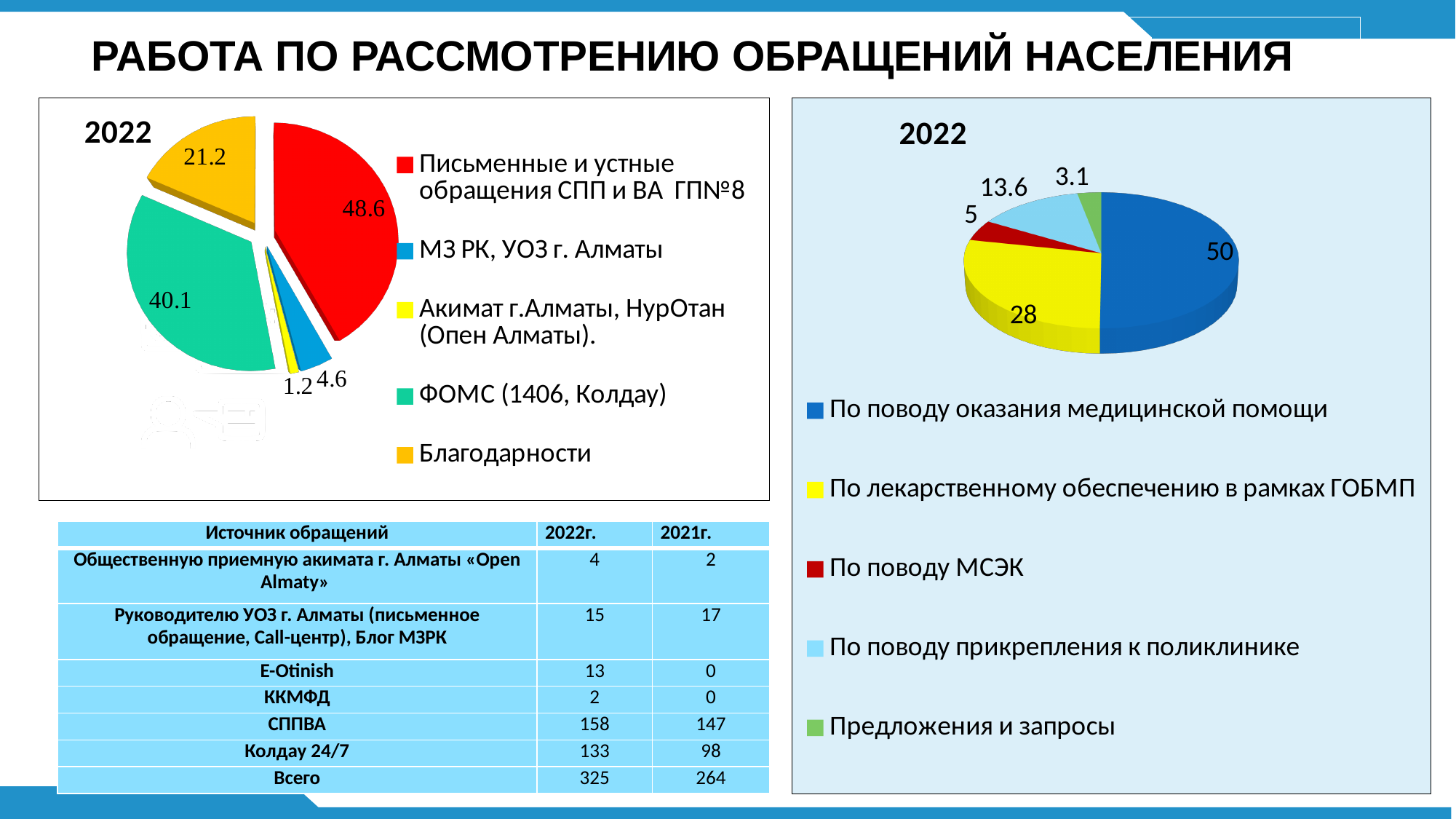
In the left pie chart, which legend category has the smallest slice? Акимат г.Алматы, НурОтан (Опен Алматы). In the right pie chart, which is larger: the value for "По поводу МСЭК" or the value for "По поводу прикрепления к поликлинике"? По поводу прикрепления к поликлинике In the right pie chart, what value is shown for "По поводу прикрепления к поликлинике"? 13.6 What type of chart is shown on the right side of the slide? Pie chart In the left pie chart, what value is shown for the slice labelled "ФОМС (1406, Колдау)"? 40.1 In the left pie chart, what value is shown for "Благодарности"? 21.2 In the left pie chart, which legend category has the largest slice? Письменные и устные обращения СПП и ВА ГП№8 In the right pie chart, which category has the smallest slice? Предложения и запросы In the left pie chart, what is the difference between the values for "Письменные и устные обращения СПП и ВА ГП№8" and "ФОМС (1406, Колдау)"? 8.5 In the right pie chart, which category has the largest slice? По поводу оказания медицинской помощи How many categories does the legend of the left pie chart list? 5 In the right pie chart, what value is shown for "По лекарственному обеспечению в рамках ГОБМП"? 28